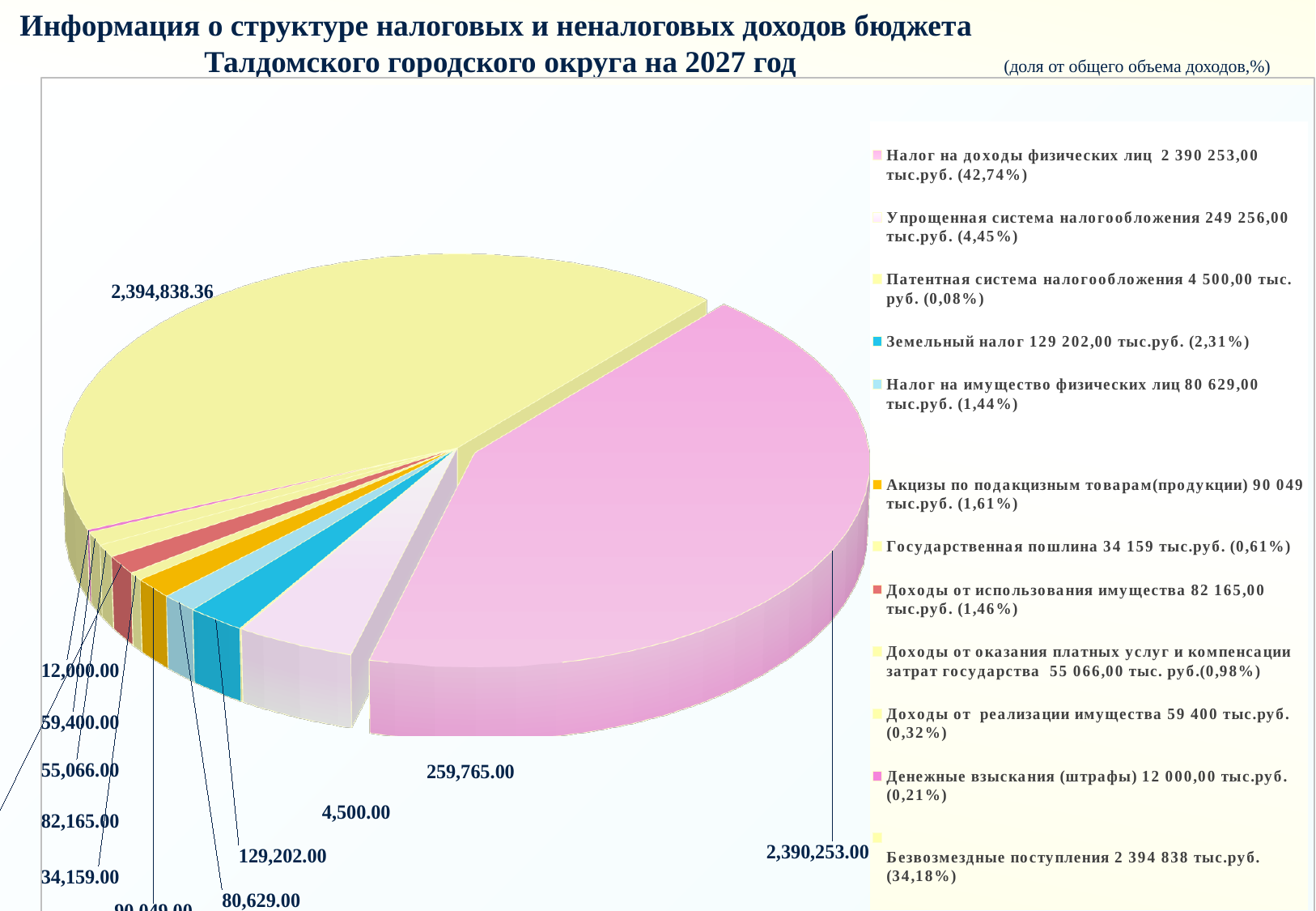
What share of total revenue does Безвозмездные поступления represent according to the legend? 34,18% What is the data label value for the Налог на имущество физических лиц slice? 80,629.00 What kind of chart is shown on the slide? pie chart What share of total revenue does Налог на доходы физических лиц represent according to the legend? 42,74% What year does the chart title say the budget revenue structure refers to? 2027 How many slices does the pie chart have? 12 What is the data label value for the Патентная система налогообложения slice? 4,500.00 What is the data label value for the Денежные взыскания (штрафы) slice? 12,000.00 Which is larger: the value for Земельный налог or the value for Налог на имущество физических лиц? Земельный налог What is the data label value for the Земельный налог slice? 129,202.00 What is the difference between the data label values for Земельный налог and Налог на имущество физических лиц? 48,573.00 Which category has the smallest slice in the pie chart? Патентная система налогообложения